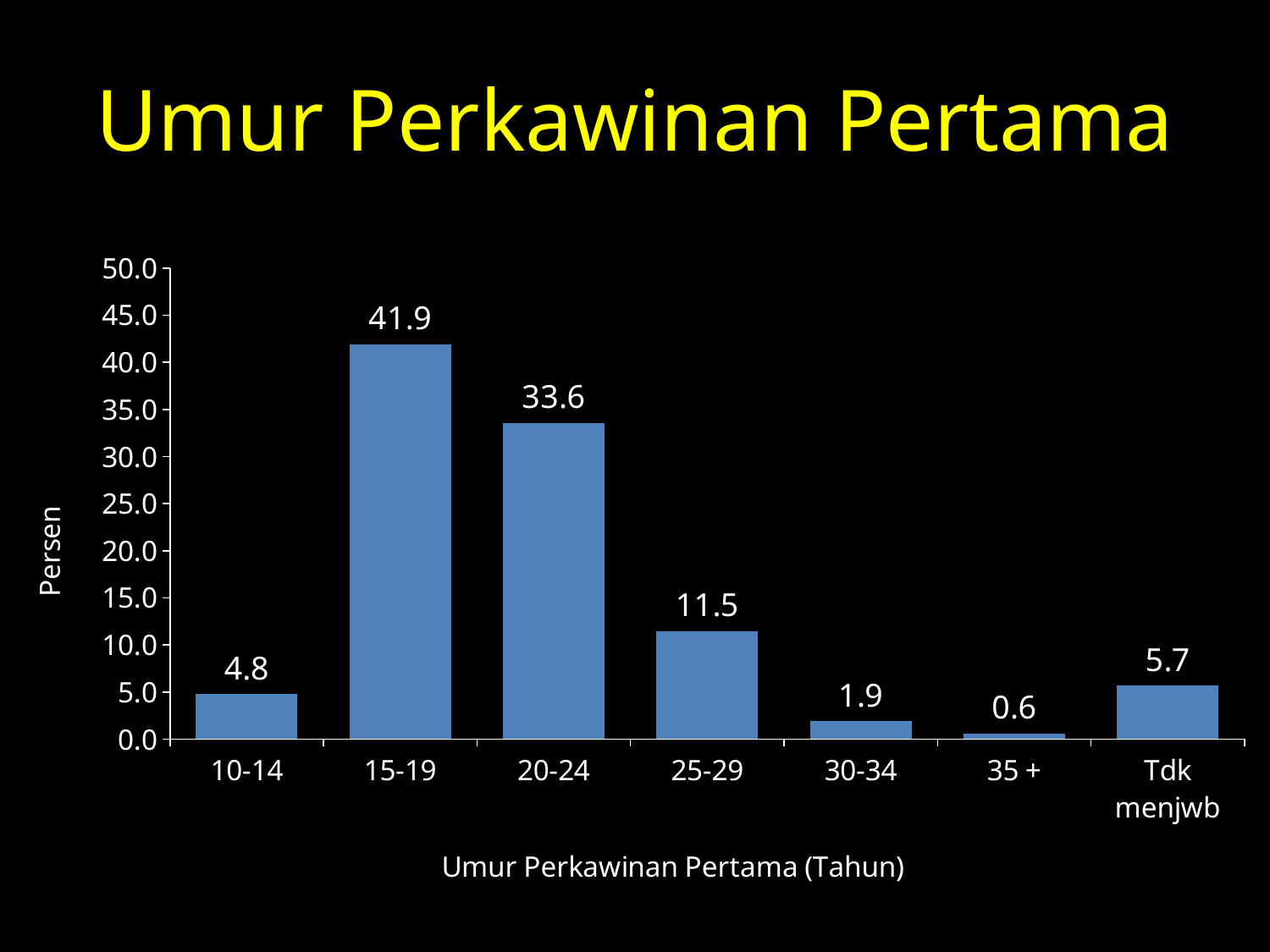
What is the value for the 25-29 age group? 11.5 Which age group has the highest value? 15-19 What is the value for the 15-19 age group? 41.9 What is the difference between the values for 15-19 and 20-24? 8.3 Which is larger, the value for 10-14 or the value for 30-34? 10-14 How many categories are shown on the x axis? 7 What is the label of the y axis? Persen What is the title of the slide? Umur Perkawinan Pertama Is the value for 20-24 greater or less than 30.0? greater What kind of chart is shown on the slide? Bar chart What is the value for the 'Tdk menjwb' category? 5.7 Which category has the lowest value? 35 +